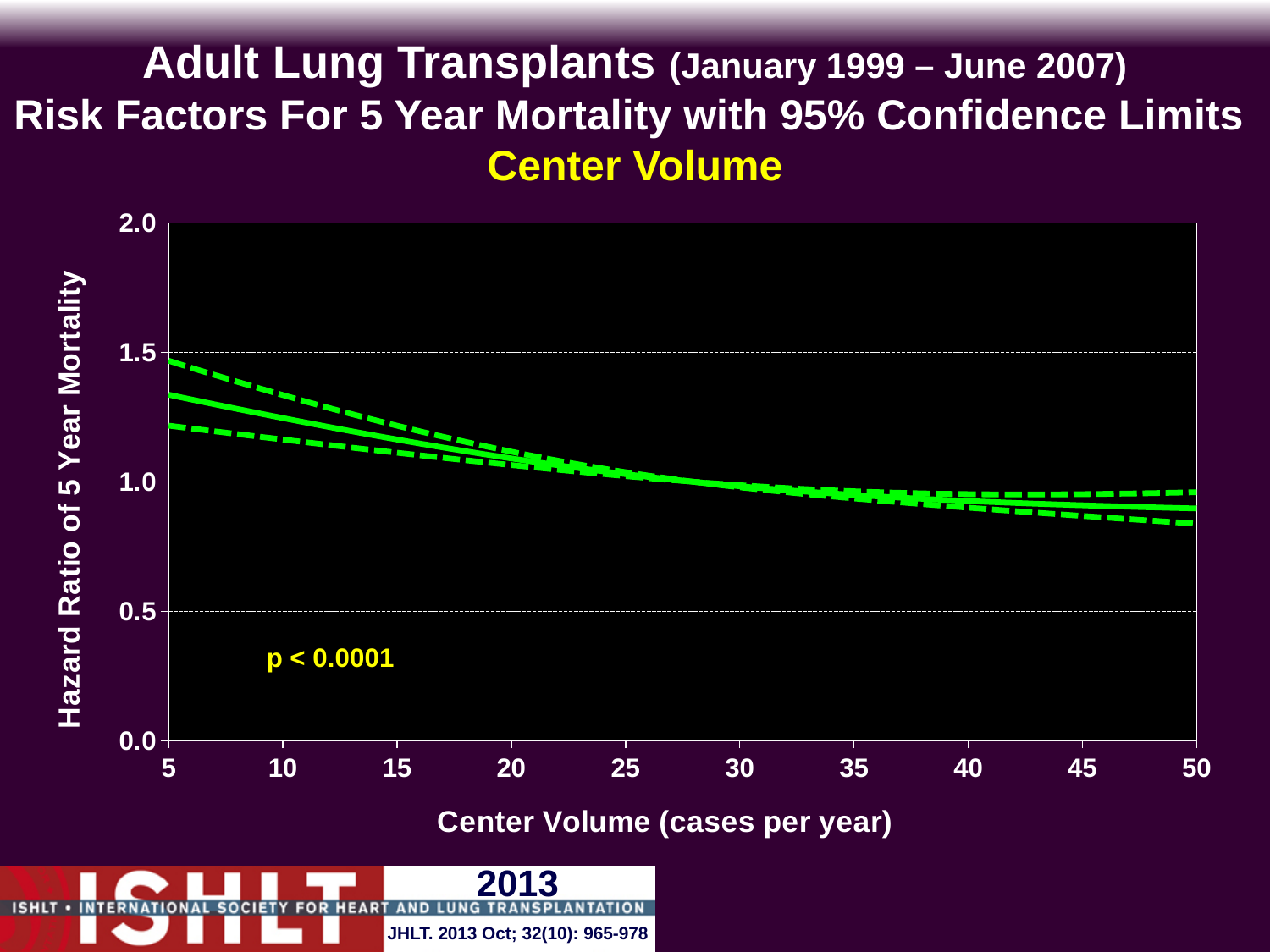
Is the hazard ratio (solid line) at a center volume of 50 cases per year greater or less than 1.0? less What kind of chart is shown on the slide? line chart Is the hazard ratio (solid line) at a center volume of 5 cases per year greater or less than 1.5? less Is the lower confidence limit (lower dashed line) at a center volume of 50 cases per year greater or less than 1.0? less What is the label of the x axis? Center Volume (cases per year) Is the hazard ratio at a center volume of 5 cases per year larger or smaller than at 50 cases per year? larger How many lines are plotted on the chart? 3 Does the hazard ratio rise or fall as center volume increases along the x axis? fall What p-value is printed on the chart? p < 0.0001